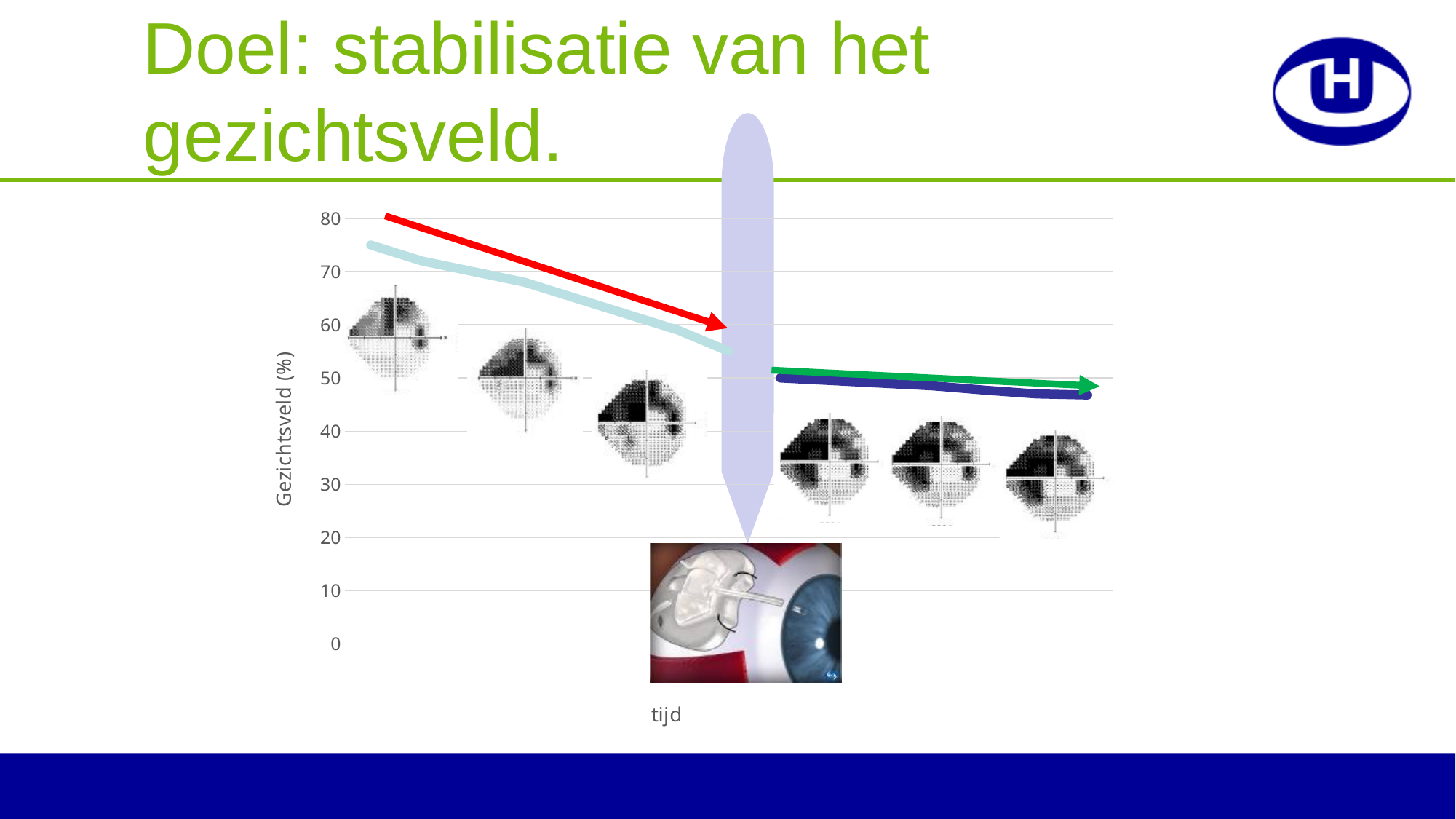
Is the ending value of the light blue line greater or less than 60? less What is the highest value shown on the vertical axis? 80 Is the dark blue line on the right side of the chart greater or less than 40? greater What kind of chart is shown on the slide? line chart Does the light blue line rise or fall along the x axis? fall Which is larger: the starting value of the light blue line or the ending value of the dark blue line? the starting value of the light blue line What is the title of the horizontal axis of the chart? tijd Is the starting value of the light blue line greater or less than 70? greater Does the red arrow on the chart point upward or downward along the x axis? downward How many tick labels are shown on the vertical axis? 9 What is the title of the vertical axis of the chart? Gezichtsveld (%)